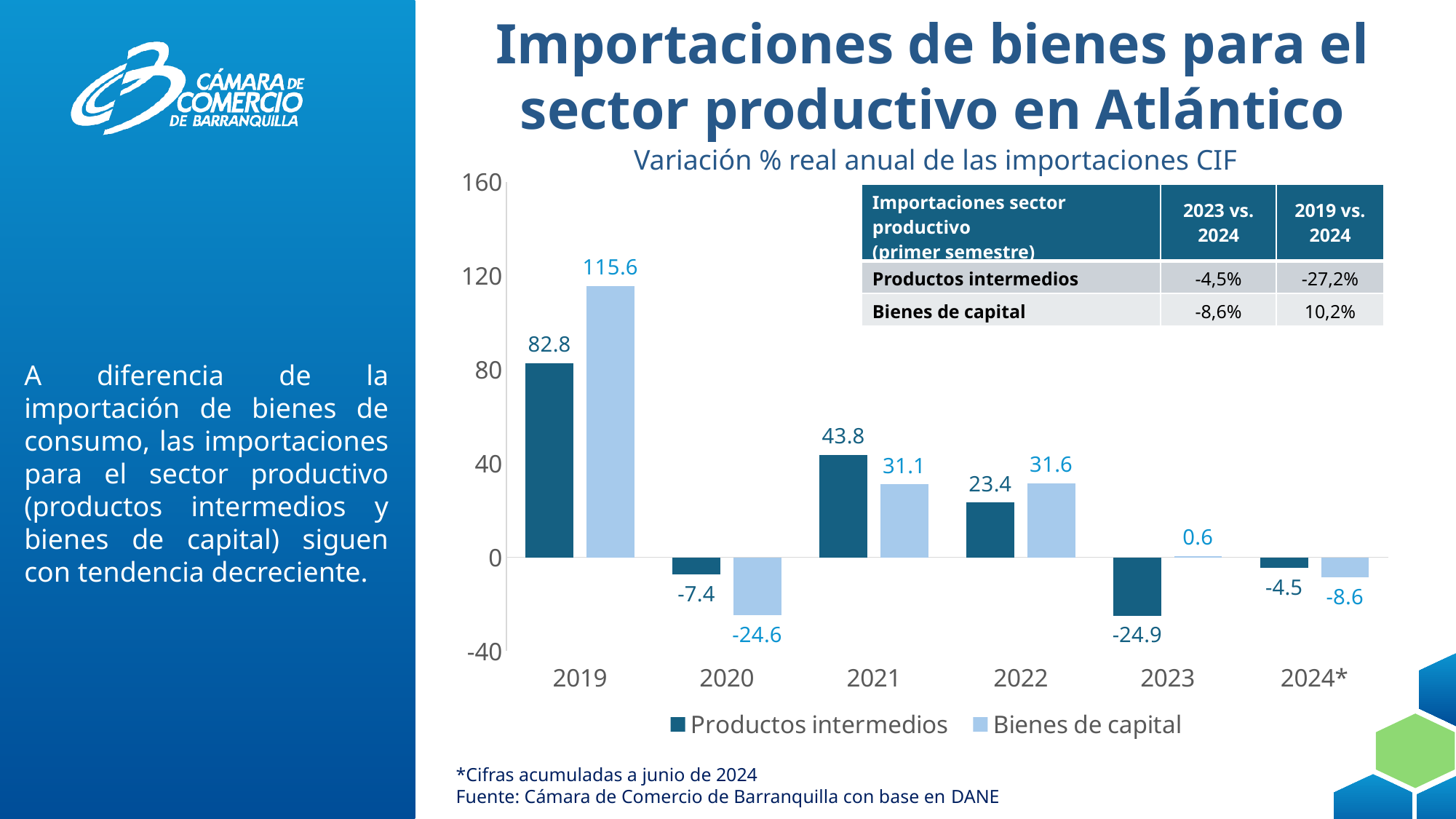
What kind of chart is shown? Bar chart How many years are shown on the x axis? 6 What is the value for Productos intermedios in 2019? 82.8 What is the difference between Bienes de capital and Productos intermedios in 2019? 32.8 Which is larger in 2021, Productos intermedios or Bienes de capital? Productos intermedios What is the value for Bienes de capital in 2020? -24.6 What is the value for Productos intermedios in 2024*? -4.5 What is the value for Bienes de capital in 2023? 0.6 In which year is Bienes de capital highest? 2019 In which year is Productos intermedios lowest? 2023 What is the subtitle of the chart? Variación % real anual de las importaciones CIF How many series does the legend list? 2